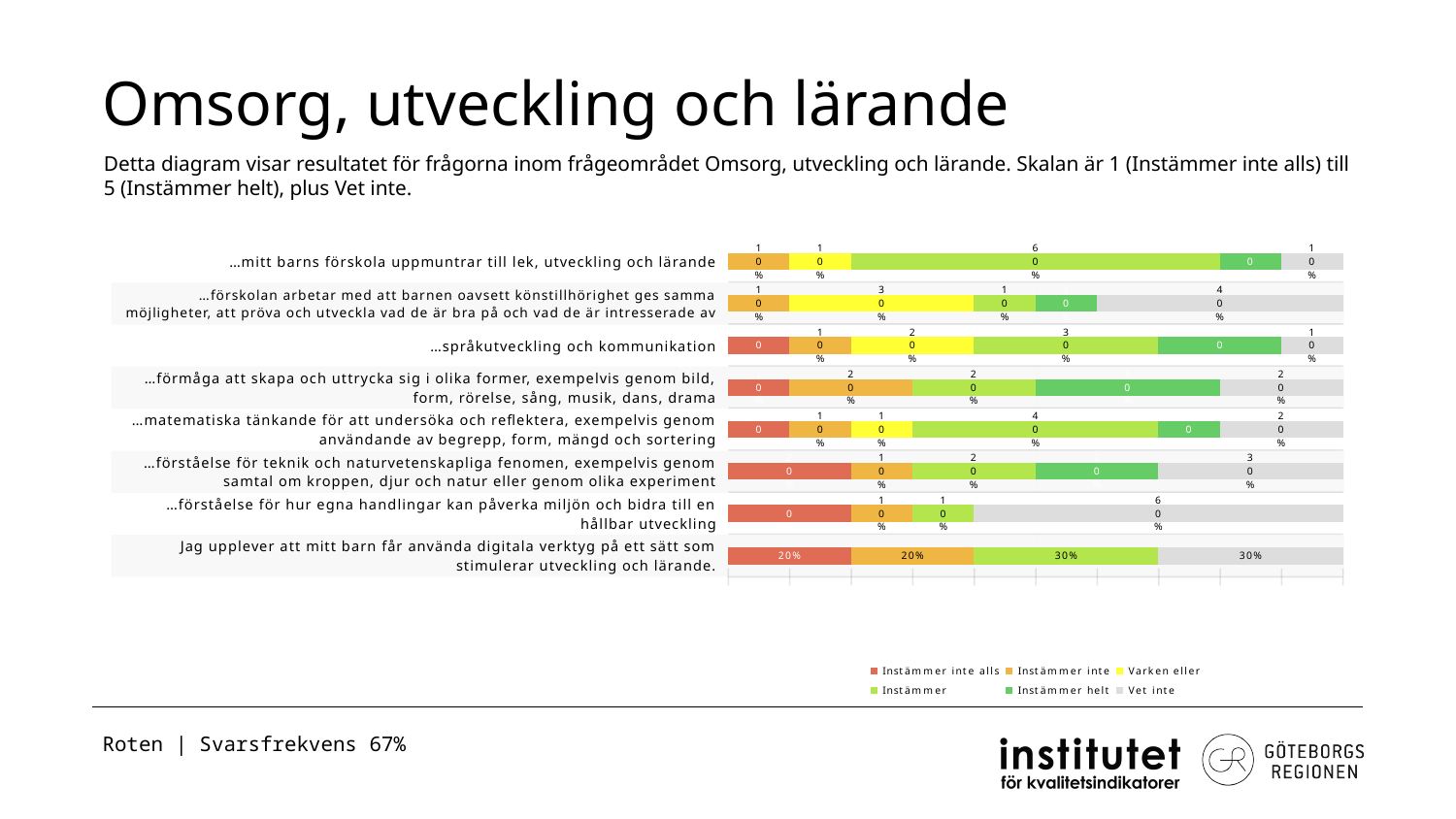
Which legend entry is shown in grey? Vet inte How many series does the legend list? 6 In the row 'Jag upplever att mitt barn får använda digitala verktyg...', what is the difference between 'Instämmer' and 'Instämmer inte alls'? 10 percentage points What is the value for 'Instämmer' in the row '…mitt barns förskola uppmuntrar till lek, utveckling och lärande'? 60% What is the total of the stacked bar for 'Jag upplever att mitt barn får använda digitala verktyg på ett sätt som stimulerar utveckling och lärande.'? 100% What kind of chart is shown on the slide? Stacked bar chart What is the value for 'Instämmer' in the row 'Jag upplever att mitt barn får använda digitala verktyg på ett sätt som stimulerar utveckling och lärande.'? 30% What is the value for 'Instämmer inte alls' in the row 'Jag upplever att mitt barn får använda digitala verktyg på ett sätt som stimulerar utveckling och lärande.'? 20% How many question categories are plotted in the chart? 8 What is the value for 'Vet inte' in the row 'Jag upplever att mitt barn får använda digitala verktyg på ett sätt som stimulerar utveckling och lärande.'? 30% What is the response rate (Svarsfrekvens) stated on the slide? 67% In the row 'Jag upplever att mitt barn får använda digitala verktyg...', which is larger: 'Instämmer' or 'Instämmer inte'? Instämmer